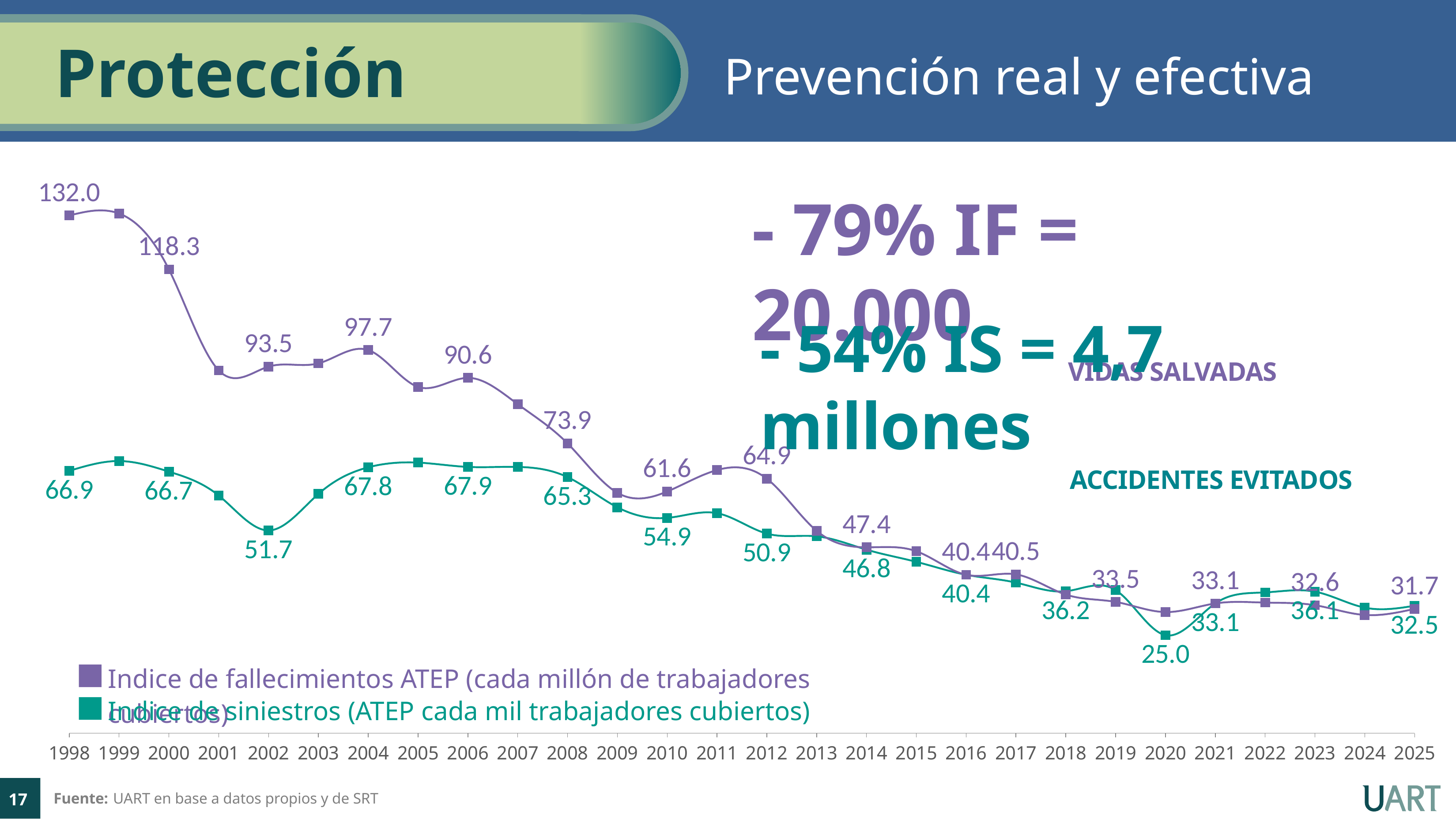
What is the value of the Indice de fallecimientos ATEP series in 1998? 132.0 What is the value of the Indice de siniestros series in 2020? 25.0 What is the value of the Indice de siniestros series in 2002? 51.7 How many series does the legend list? 2 In 1998, which series has the larger value: Indice de fallecimientos ATEP or Indice de siniestros? Indice de fallecimientos ATEP What type of chart is shown on the slide? line chart What is the value of the Indice de siniestros series in 1998? 66.9 Overall, does the Indice de fallecimientos ATEP series rise or fall from 1998 to 2025? fall What is the difference between the Indice de fallecimientos ATEP values in 1998 and 2025? 100.3 In which year is the Indice de siniestros series at its lowest? 2020 What is the value of the Indice de fallecimientos ATEP series in 2025? 31.7